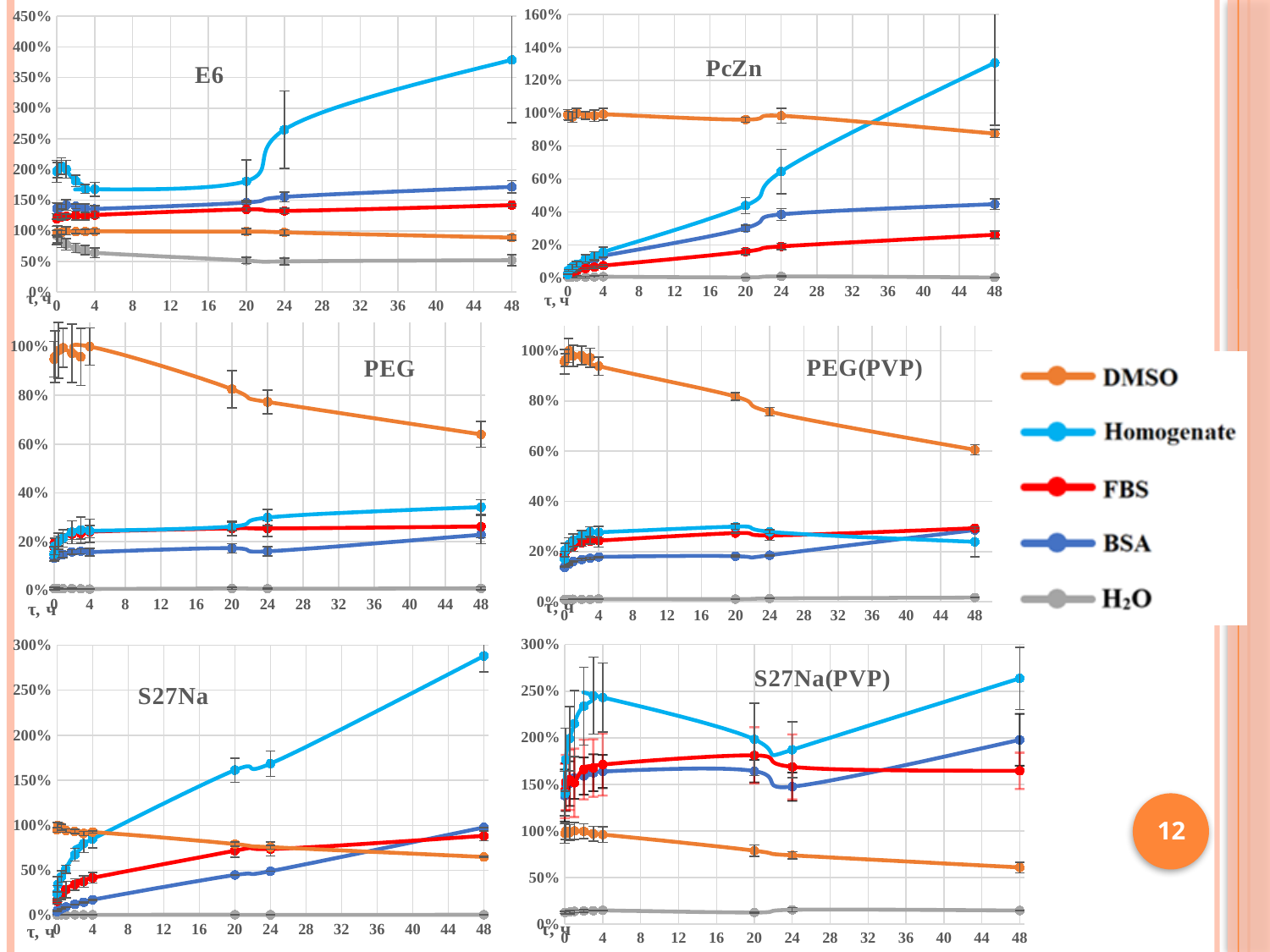
In the S27Na chart, is the Homogenate value at 48 greater or less than 250%? greater In the E6 chart, which series has the lowest value at 48? H2O In the PEG chart, is the DMSO value at 48 greater or less than 80%? less In the PcZn chart, which series has the highest value at 48? Homogenate In the S27Na(PVP) chart, which is larger at 48, Homogenate or BSA? Homogenate How many series does the legend list? 5 In the PEG(PVP) chart, does the DMSO series rise or fall from 0 to 48? fall What kind of chart is the E6 chart? line chart In the PcZn chart, is the DMSO value at 48 greater or less than 100%? less In the S27Na chart, which series has the lowest value at 48? H2O How many charts are shown on the slide? 6